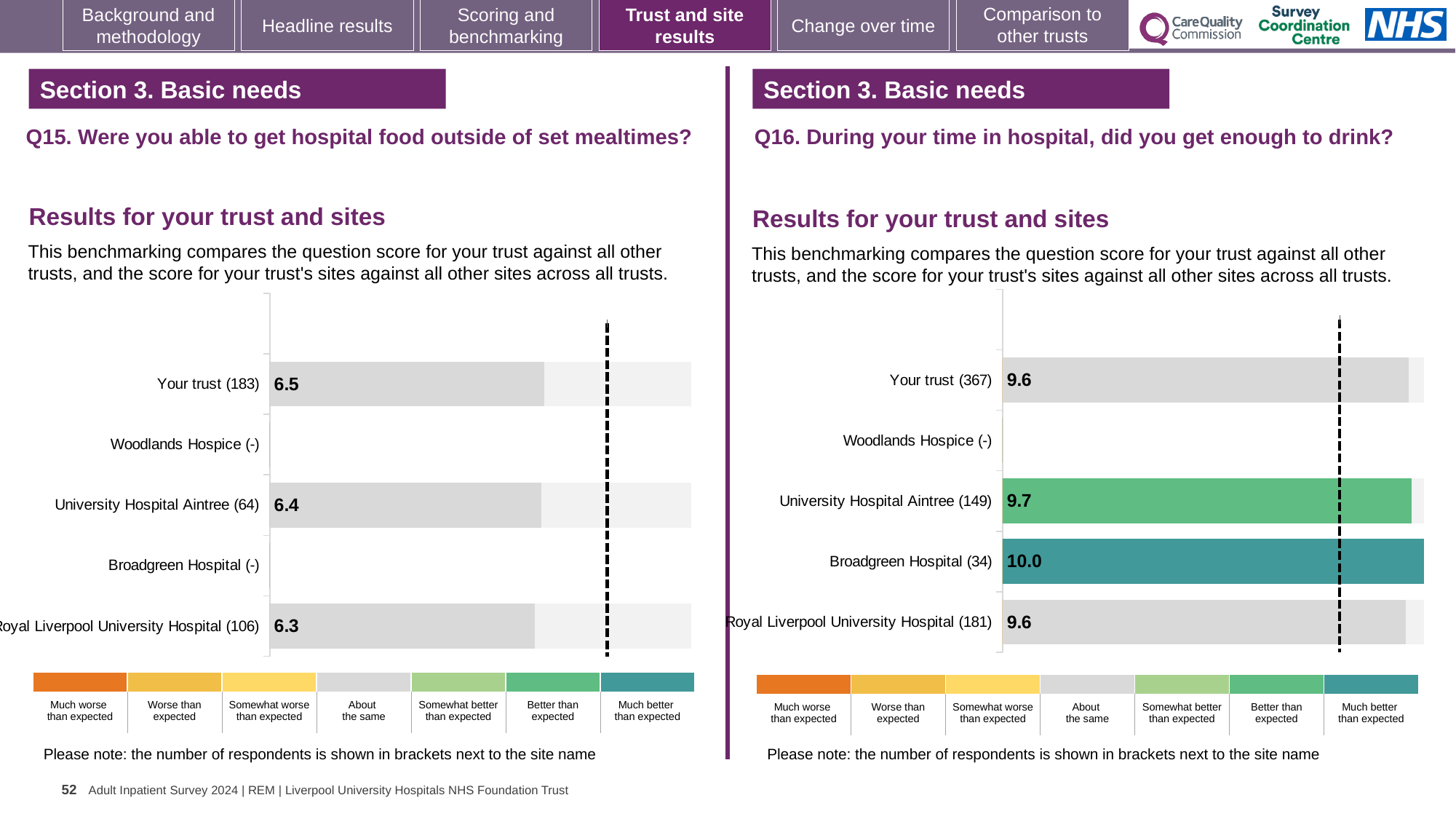
In the Q16 chart (right), how many respondents are shown in brackets for Your trust? 367 In the Q16 chart (right), what is the score for University Hospital Aintree? 9.7 In the Q16 chart (right), what is the score for Broadgreen Hospital? 10.0 In the Q15 chart (left), what is the score for Royal Liverpool University Hospital? 6.3 In the Q16 chart (right), what is the difference between the score for Broadgreen Hospital and the score for Your trust? 0.4 In the Q16 chart (right), what colour is the bar for Broadgreen Hospital? Teal In the Q15 chart (left), what is the score for Your trust? 6.5 In the Q16 chart (right), which is larger: the score for University Hospital Aintree or the score for Royal Liverpool University Hospital? University Hospital Aintree In the Q15 chart (left), what is the difference between the score for Your trust and the score for Royal Liverpool University Hospital? 0.2 What kind of chart is used in the Q15 chart (left)? Bar chart In the Q15 chart (left), what is the score for University Hospital Aintree? 6.4 In the Q16 chart (right), which site has the highest score? Broadgreen Hospital